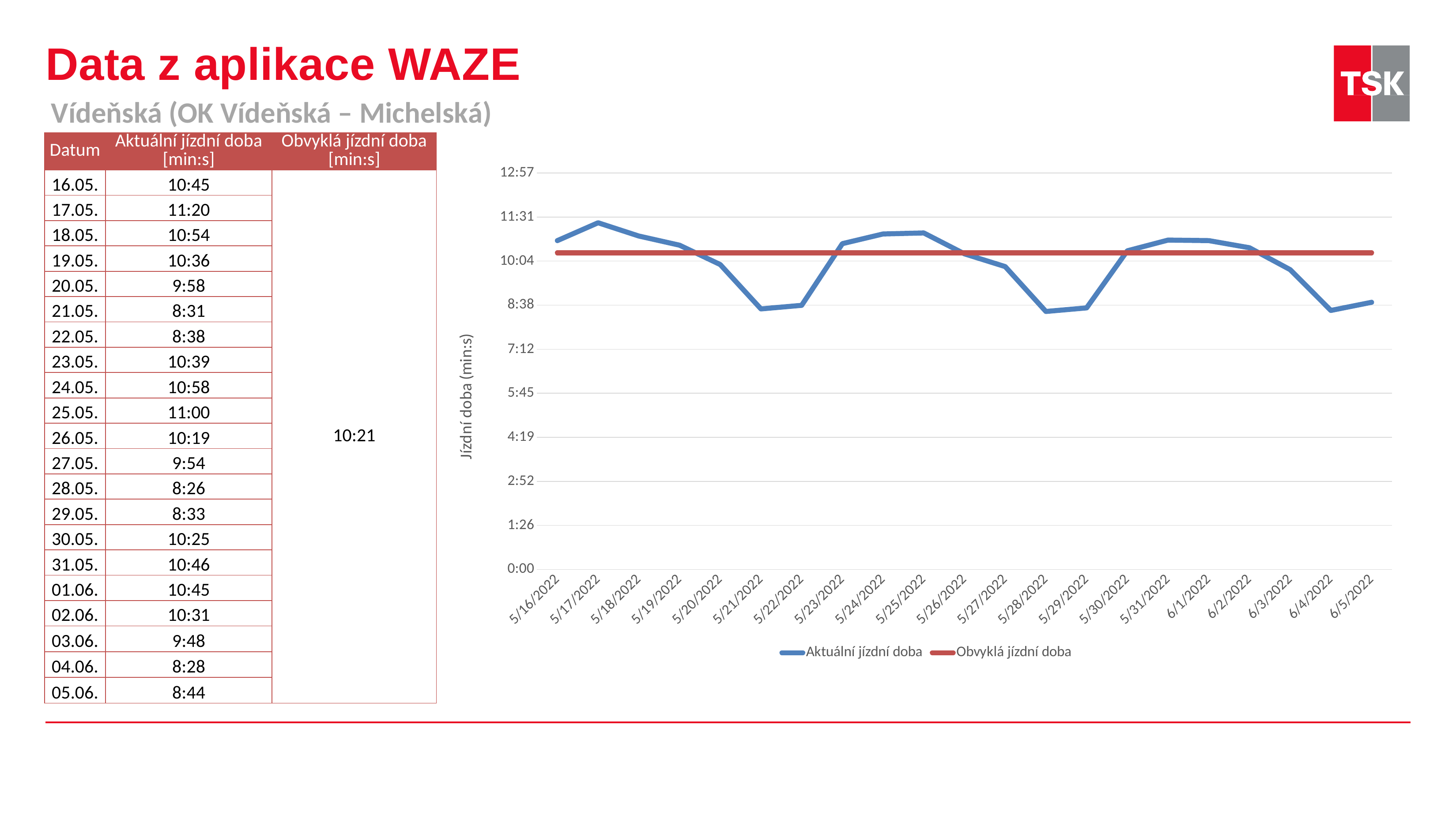
How many series does the chart legend list? 2 Which is larger, the Aktuální jízdní doba on 5/17/2022 or on 5/21/2022? 5/17/2022 Is the Aktuální jízdní doba for 5/21/2022 greater or less than 10:04? less What is the value of Obvyklá jízdní doba shown as the flat line in the chart? 10:21 How many dates are plotted along the x axis of the chart? 21 What is the Aktuální jízdní doba for 5/21/2022? 8:31 Does the Aktuální jízdní doba rise or fall from 5/18/2022 to 5/21/2022? fall What kind of chart is shown on the slide? line chart On which date is the Aktuální jízdní doba highest? 5/17/2022 What is the difference between the Aktuální jízdní doba on 5/17/2022 and on 5/21/2022? 2:49 What is the Aktuální jízdní doba for 5/25/2022? 11:00 Is the Aktuální jízdní doba for 5/24/2022 greater or less than 10:04? greater